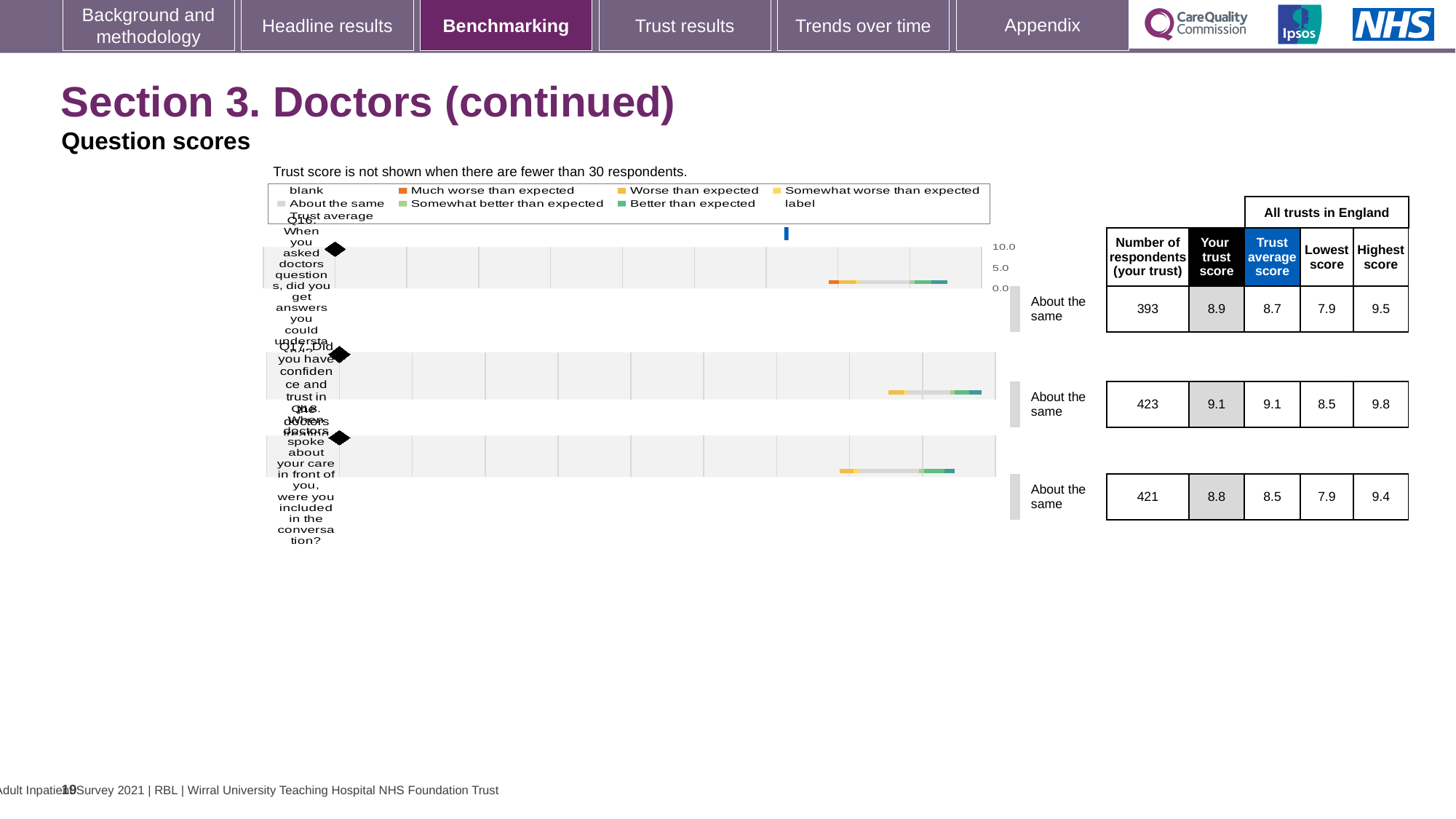
What is the difference between the highest score and the lowest score across all trusts in England for Q16? 1.6 What is the trust average score for Q18 (being included in the conversation when doctors spoke about your care)? 8.5 What benchmark category is shown for Q16? About the same What is the maximum value shown on the score axis of the chart? 10.0 What is the trust score for Q16 (getting answers you could understand from doctors)? 8.9 Which of the three questions has the lowest trust score? Q18 What is the trust score for Q17 (confidence and trust in the doctors)? 9.1 How many questions (categories) are plotted in the chart? 3 Which of the three questions has the highest trust score? Q17 What kind of chart is used to show the question scores on this slide? bar chart How many respondents answered Q17 at this trust? 423 Is the trust score for Q18 larger or smaller than the trust average score for Q18? larger